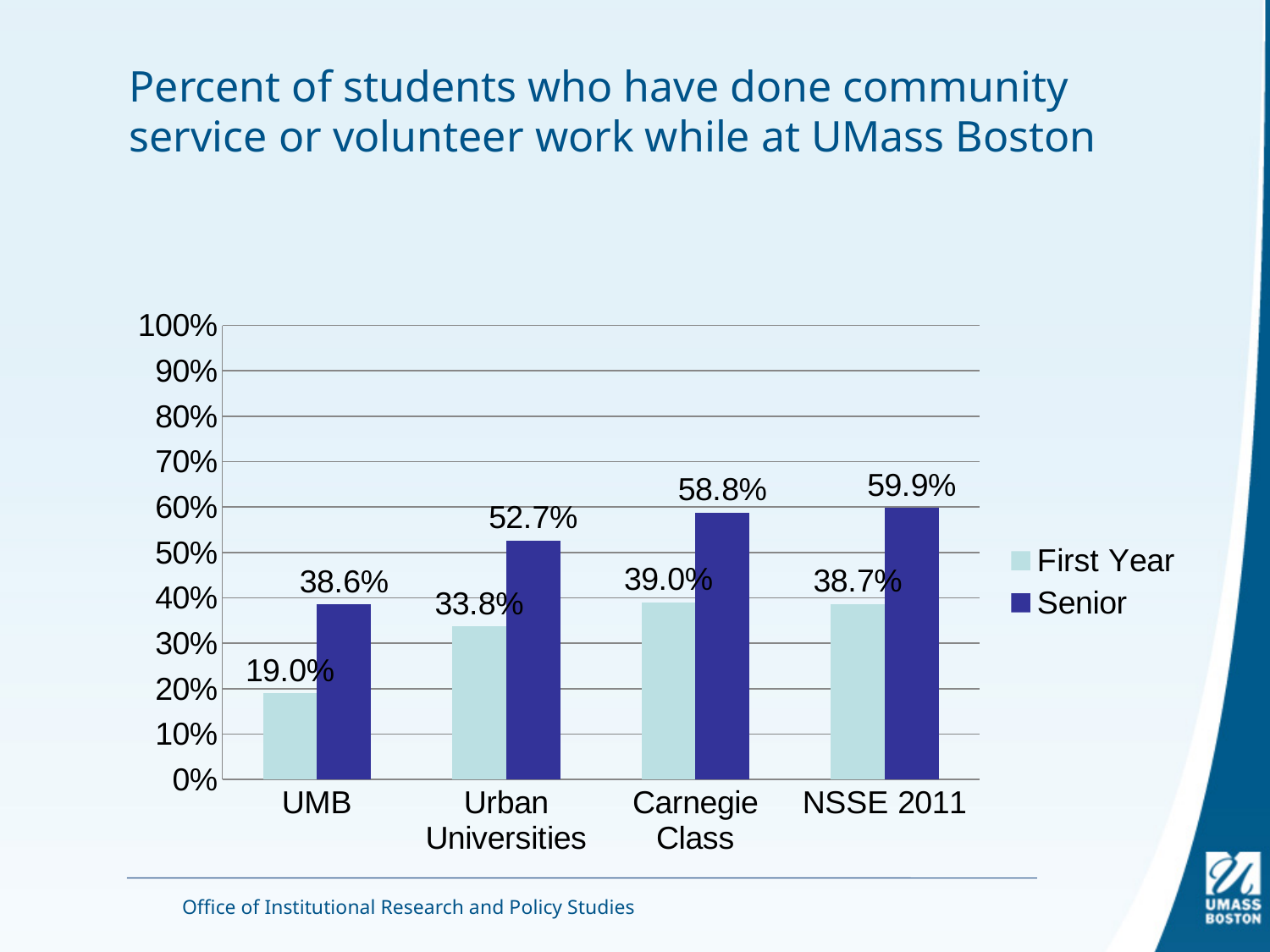
What is the First Year value for UMB? 19.0% What is the First Year value for Carnegie Class? 39.0% How many categories are shown on the x axis? 4 Which category has the lowest First Year value? UMB Is the Senior value for Carnegie Class greater or less than 50%? greater What is the Senior value for NSSE 2011? 59.9% How many series does the legend list? 2 Which category has the lowest Senior value? UMB What kind of chart is shown on the slide? bar chart What is the difference between the Senior and First Year values for UMB? 19.6% Which is larger, the First Year value for Urban Universities or the First Year value for NSSE 2011? NSSE 2011 What is the Senior value for Urban Universities? 52.7%